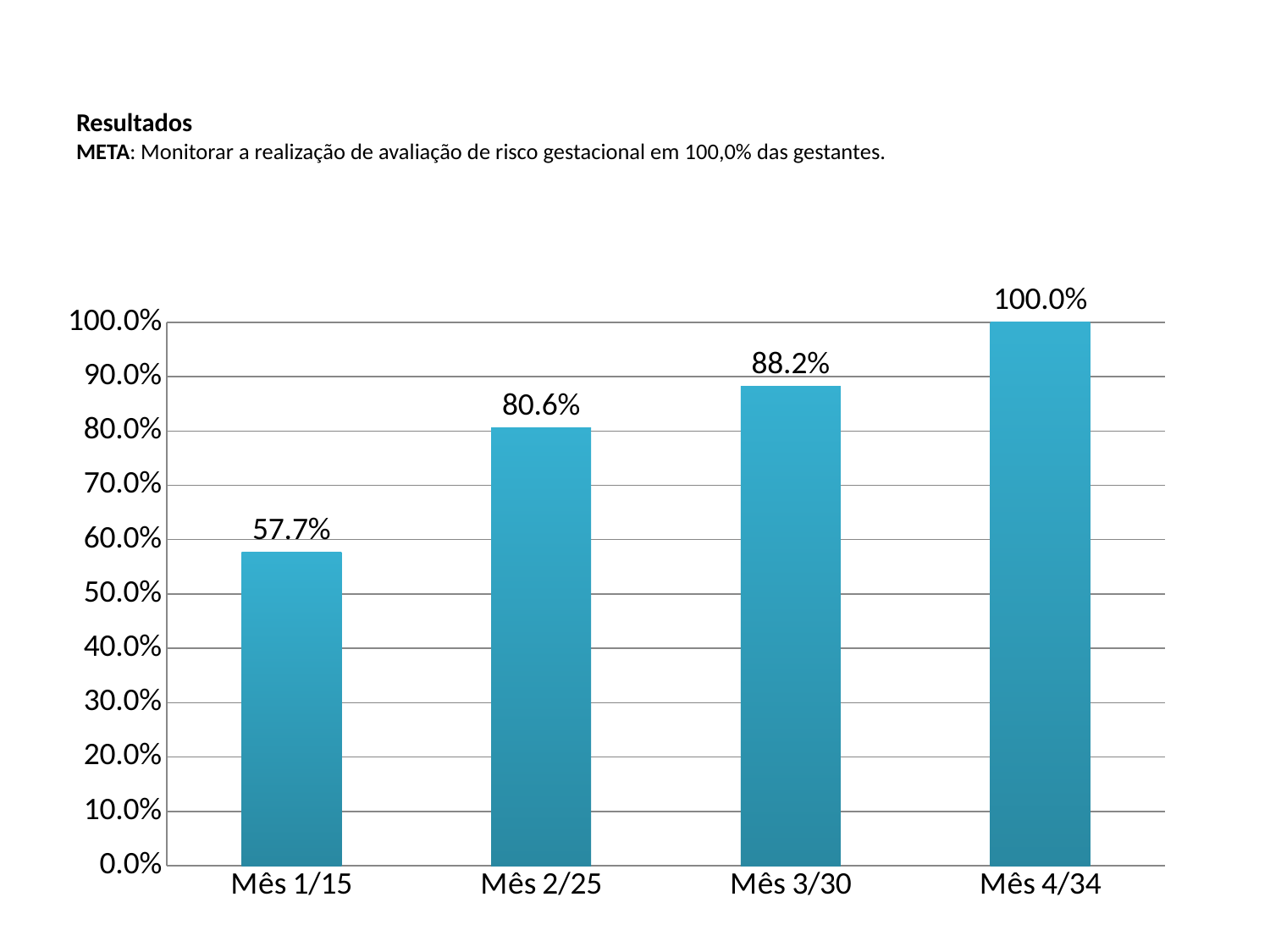
What is the difference between the values for Mês 4/34 and Mês 3/30? 11.8% What is the difference between the values for Mês 2/25 and Mês 1/15? 22.9% Which is larger, the value for Mês 2/25 or the value for Mês 3/30? Mês 3/30 Which category has the highest value? Mês 4/34 What is the value for Mês 3/30? 88.2% Which category has the lowest value? Mês 1/15 What is the value for Mês 2/25? 80.6% How many categories are shown on the x axis? 4 What kind of chart is this? Bar chart What is the value for Mês 1/15? 57.7% What is the value for Mês 4/34? 100.0% Do the values rise or fall from Mês 1/15 to Mês 4/34? Rise